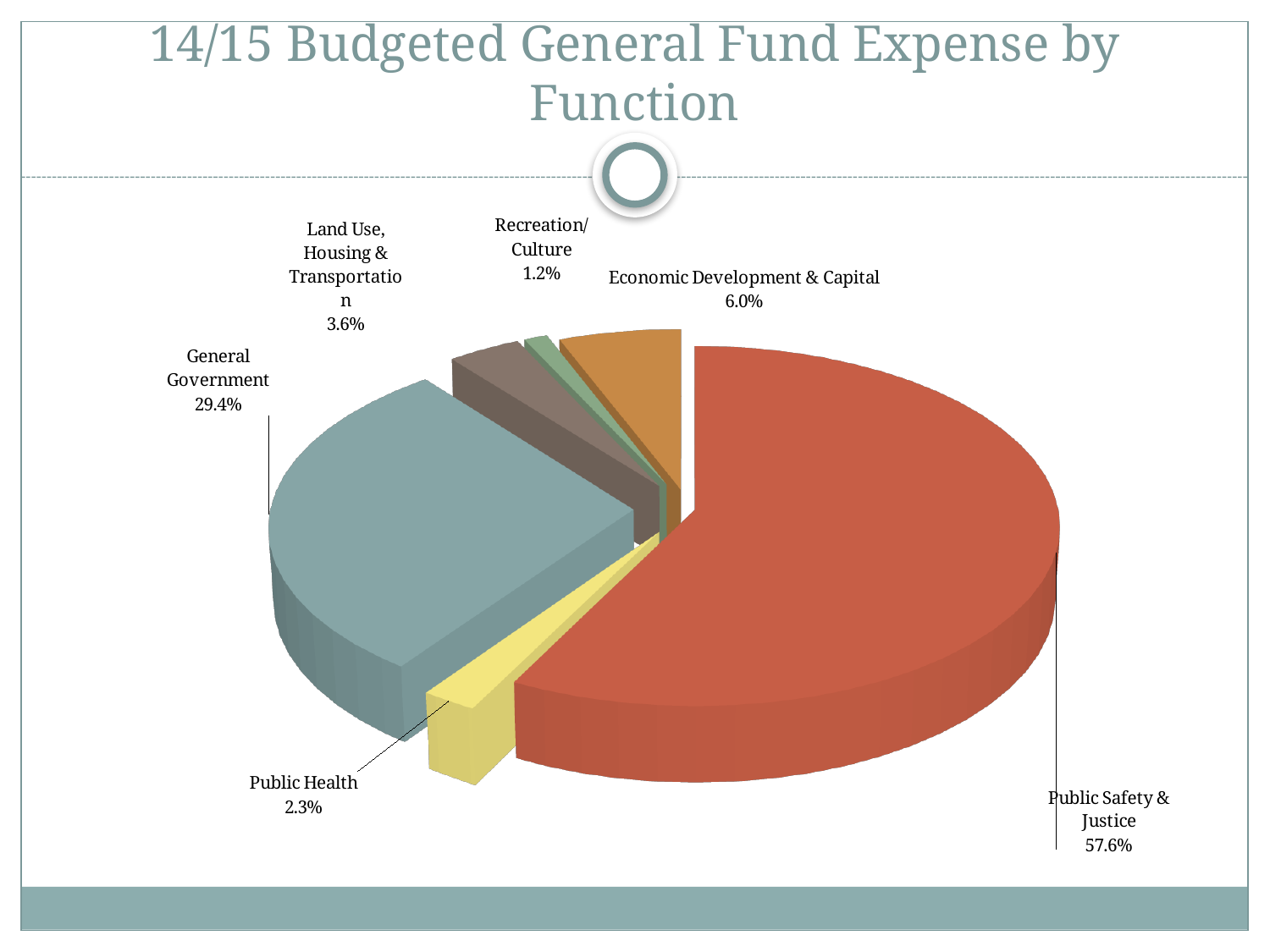
What type of chart is shown on the slide? Pie chart Which is larger, the share for Land Use, Housing & Transportation or the share for Public Health? Land Use, Housing & Transportation What is the title of the chart on the slide? 14/15 Budgeted General Fund Expense by Function Which function has the largest share of the budgeted general fund expense? Public Safety & Justice How many percentage points larger is Public Safety & Justice than General Government? 28.2 How many functions (slices) are shown in the pie chart? 6 What share of the budgeted general fund expense goes to Public Safety & Justice? 57.6% Which function has the smallest share of the budgeted general fund expense? Recreation/Culture What share does Economic Development & Capital represent? 6.0% What percentage of the pie is General Government? 29.4% What percentage is labelled for Recreation/Culture? 1.2% What is the value shown for Public Health? 2.3%